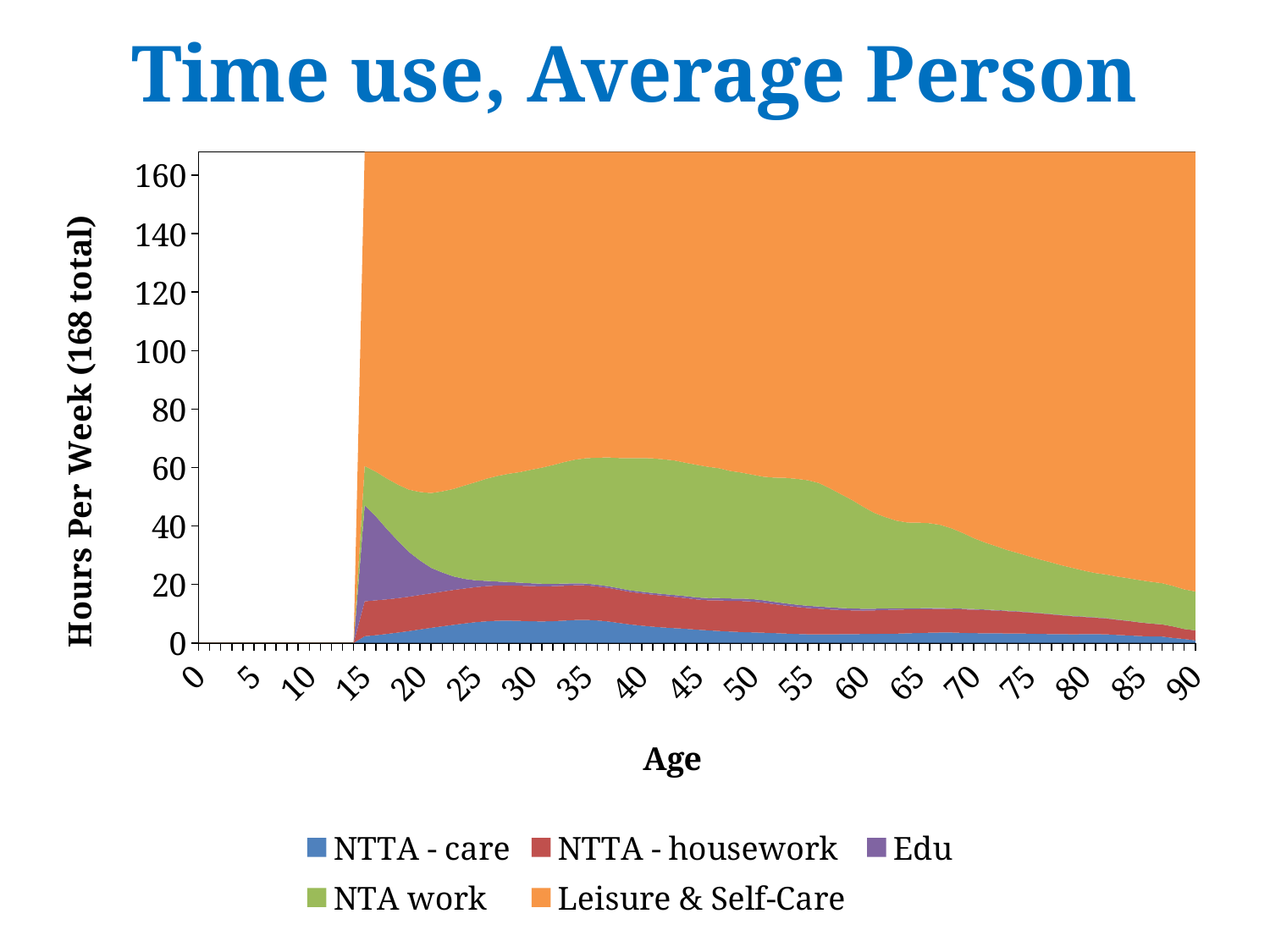
What kind of chart is shown on the slide? stacked area chart Is the Edu value at age 15 greater or less than 20 hours per week? greater Does the Edu series rise or fall between age 15 and age 30? fall What is the label on the vertical axis? Hours Per Week (168 total) What is the title of the chart? Time use, Average Person How many series does the legend list? 5 At age 40, which series is larger: Leisure & Self-Care or NTA work? Leisure & Self-Care At age 40, is the stacked top of the NTA work band greater or less than 80 hours per week? less How many age labels are shown along the x axis? 19 At what age do the plotted series first begin on the chart? 15 Which series occupies the most hours per week at every age shown? Leisure & Self-Care Does the stacked top of the NTA work band rise or fall between age 55 and age 90? fall